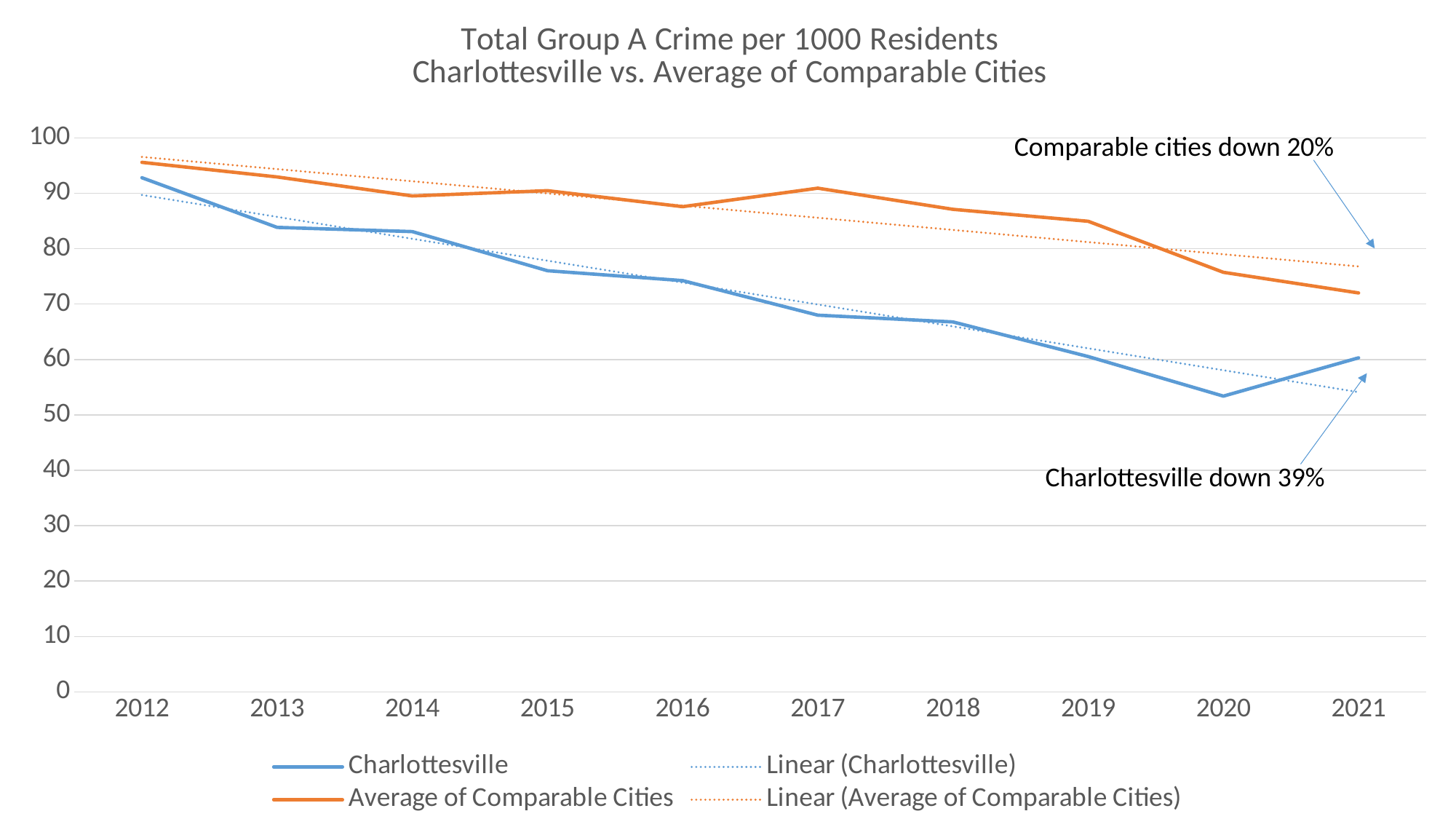
How many years are plotted along the x axis? 10 Is the Charlottesville value for 2012 greater or less than 90? greater Does the Average of Comparable Cities line generally rise or fall from 2012 to 2021? fall Is the Average of Comparable Cities value for 2021 greater or less than 80? less Is the Charlottesville value for 2020 greater or less than 60? less In which year is the Charlottesville value highest? 2012 In which year is the Charlottesville value lowest? 2020 Does the Charlottesville line generally rise or fall from 2012 to 2021? fall According to the annotation on the chart, by what percentage is Charlottesville down? 39% What kind of chart is shown on the slide? line chart In 2016, which is larger: the Charlottesville value or the Average of Comparable Cities value? Average of Comparable Cities How many series does the legend list? 4